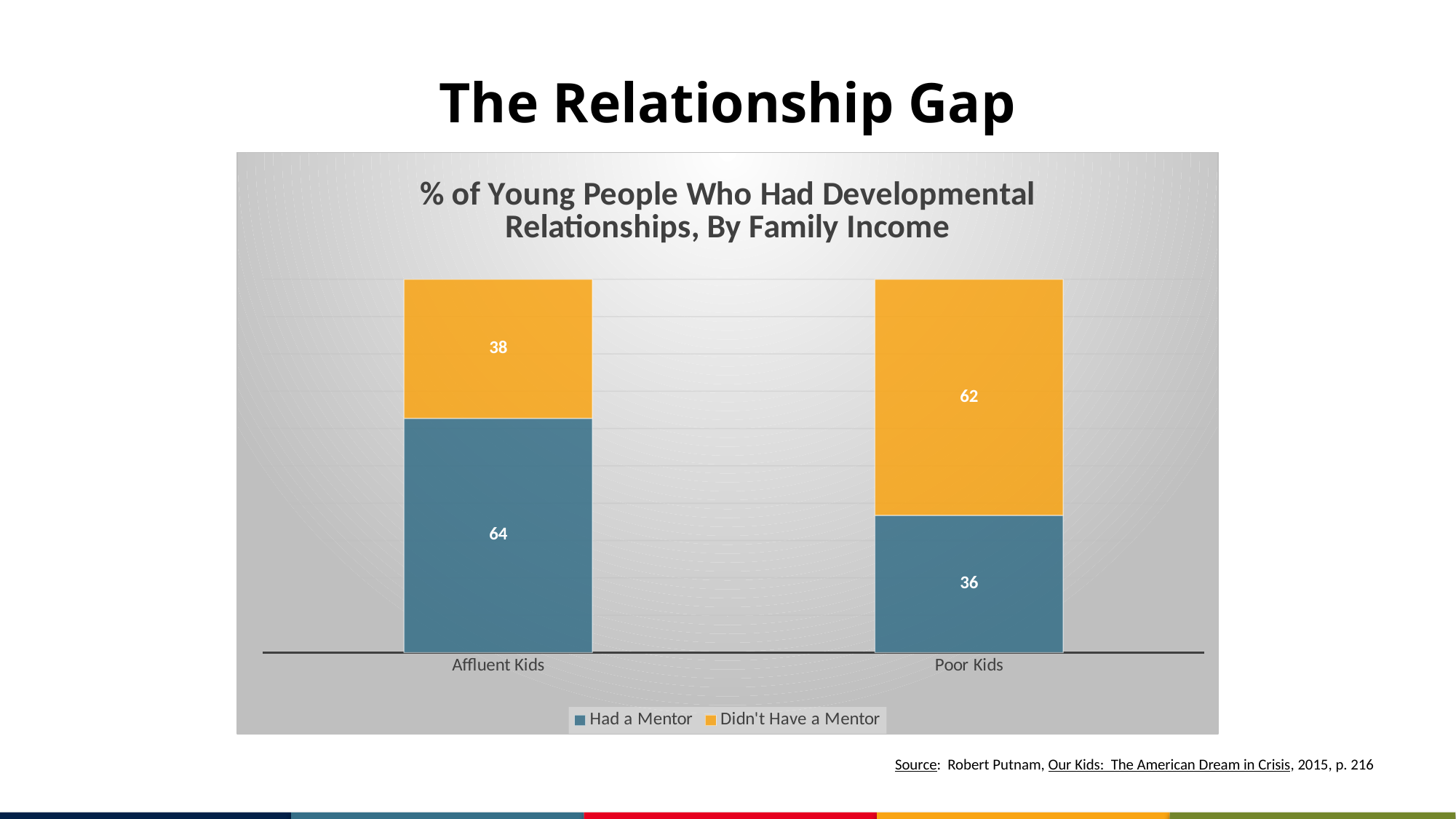
What kind of chart is shown on the slide? Stacked bar chart How many categories are shown on the x axis? 2 Which category has the higher value for Had a Mentor? Affluent Kids What is the value for Didn't Have a Mentor for Affluent Kids? 38 What is the value for Had a Mentor for Poor Kids? 36 Is the Didn't Have a Mentor value larger for Affluent Kids or Poor Kids? Poor Kids Which category has the lower value for Didn't Have a Mentor? Affluent Kids What is the value for Had a Mentor for Affluent Kids? 64 How many series does the legend list? 2 What is the value for Didn't Have a Mentor for Poor Kids? 62 What is the total of the stacked bar for Poor Kids? 98 What is the difference between the Had a Mentor values for Affluent Kids and Poor Kids? 28